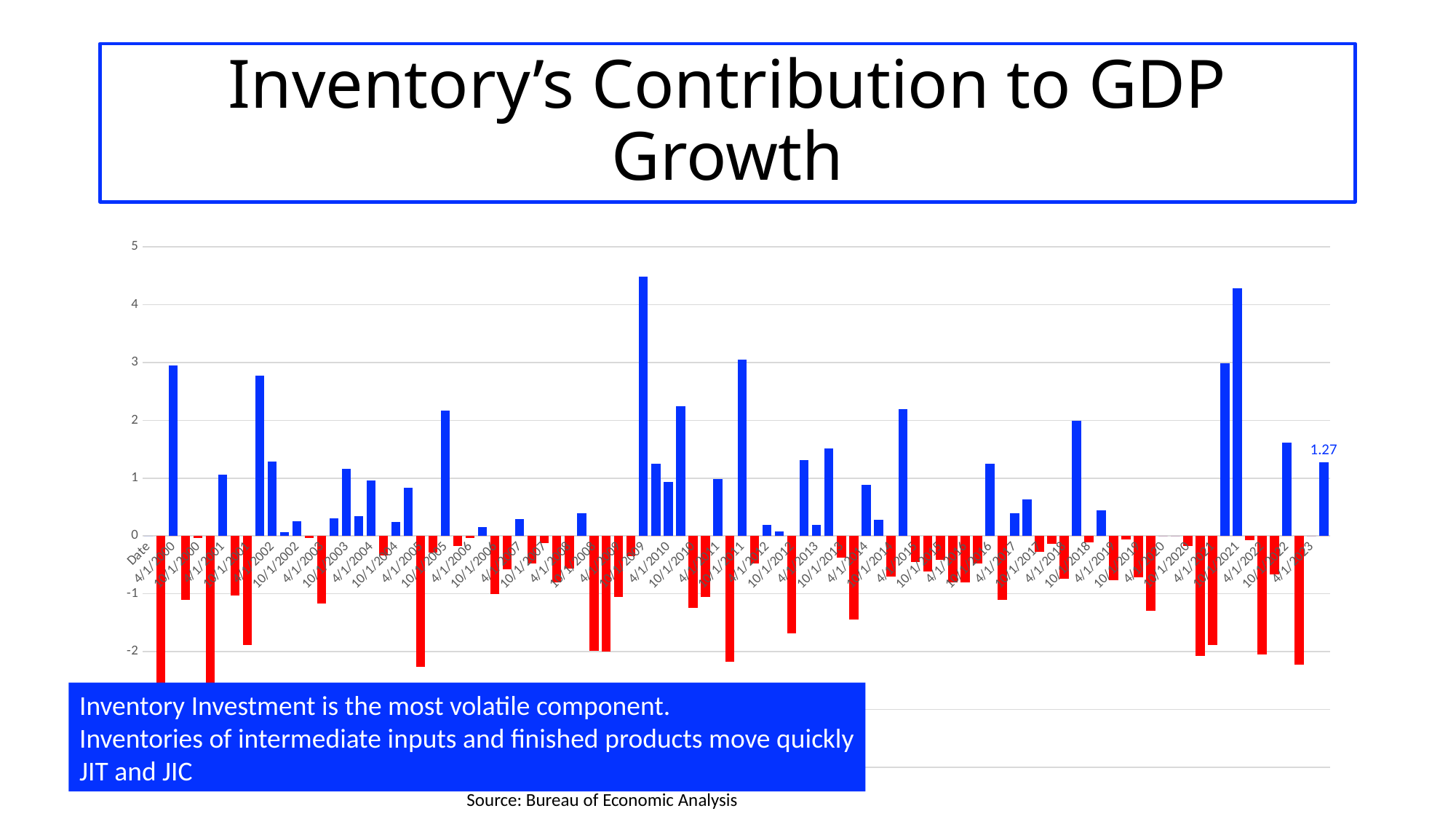
Is the value for 4/1/2023 greater or less than 2? less Is the lowest bar on the chart greater or less than -2? less What is the value of the data label shown on the last bar (4/1/2023)? 1.27 What kind of chart is shown on the slide? bar chart Is the tallest bar on the chart greater or less than 4? greater What is the highest value shown on the vertical axis? 5 What colour are the bars with negative values? red What is the title of the chart on the slide? Inventory's Contribution to GDP Growth